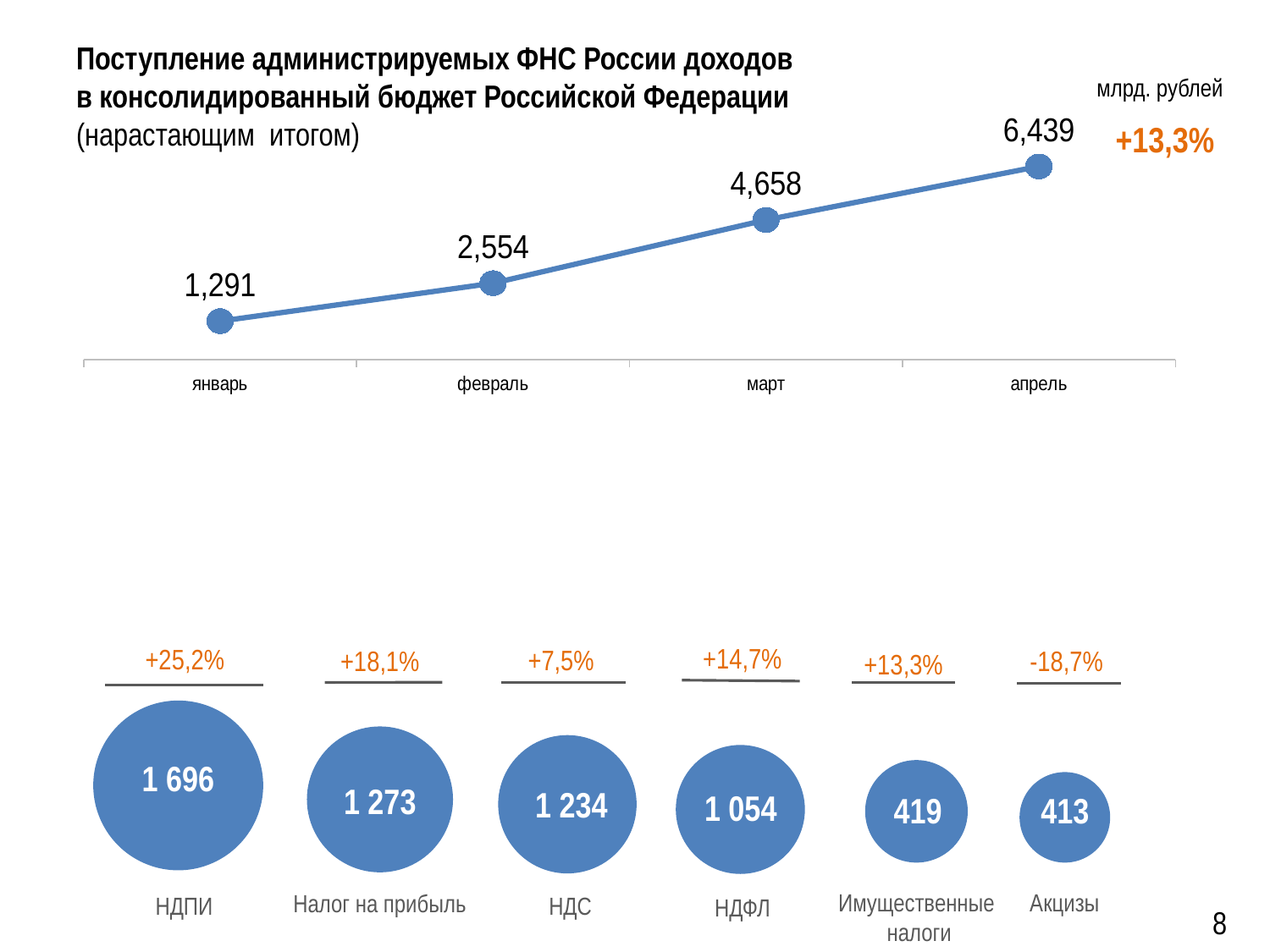
In the bottom bubble chart, what is the difference between the values for НДПИ and Налог на прибыль? 423 In the bottom bubble chart, which is larger: НДФЛ or Имущественные налоги? НДФЛ In the top line chart, which month has the highest value? апрель In the top line chart, what is the cumulative value for март? 4,658 In the bottom bubble chart, what percentage change is shown above Акцизы? -18,7% In the bottom bubble chart, what is the value for НДС? 1 234 How many months are plotted in the top line chart? 4 What kind of chart is the top chart on the slide? line chart In the bottom bubble chart, which category has the lowest value? Акцизы In the top line chart, do the values rise or fall from январь to апрель? rise In the top line chart, what is the value for январь? 1,291 In the top line chart, what is the difference between the values for апрель and март? 1,781